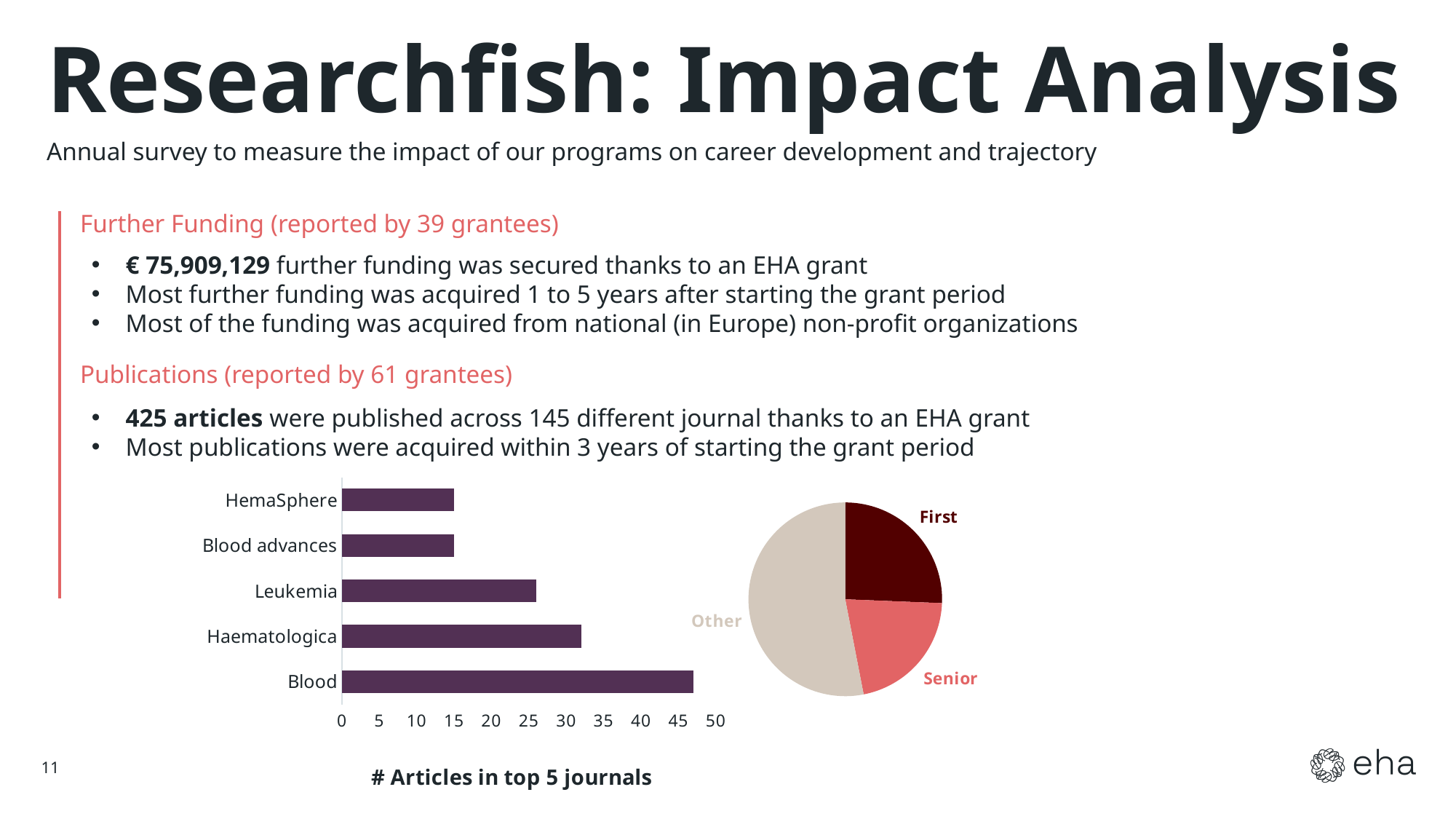
In the '# Articles in top 5 journals' chart, which has more articles, Leukemia or Haematologica? Haematologica In the pie chart on the right, how many slices are there? 3 In the '# Articles in top 5 journals' chart, how many journals are shown? 5 In the '# Articles in top 5 journals' chart, is the value for HemaSphere greater or less than 20? less What kind of chart is the chart on the right with the slices First, Senior and Other? pie chart In the '# Articles in top 5 journals' chart, is the value for Leukemia greater or less than 30? less In the '# Articles in top 5 journals' chart, is the value for Haematologica greater or less than 25? greater What kind of chart is the chart titled '# Articles in top 5 journals'? bar chart In the '# Articles in top 5 journals' chart, which has more articles, Blood or Haematologica? Blood In the pie chart on the right, which slice is the largest? Other In the '# Articles in top 5 journals' chart, which journal has the highest number of articles? Blood